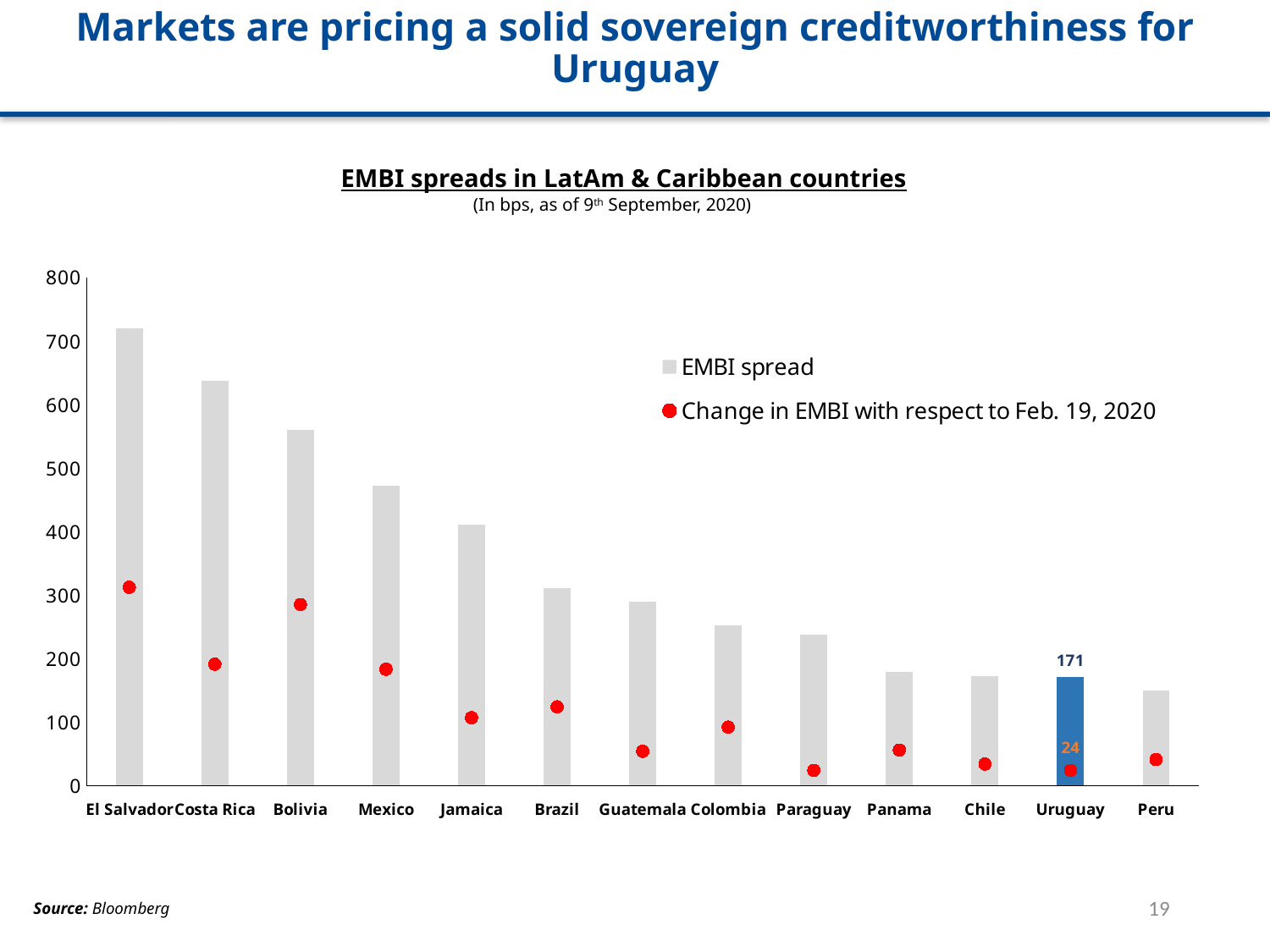
What kind of chart is used to show the EMBI spreads? Bar chart How many series does the legend list? 2 Which country has the lowest EMBI spread? Peru How many countries are shown on the x axis? 13 What is the change in EMBI with respect to Feb. 19, 2020 shown for Uruguay? 24 Which has a larger EMBI spread, Costa Rica or Bolivia? Costa Rica What is the EMBI spread value shown for Uruguay? 171 Do the EMBI spread bars rise or fall from left to right across the countries? Fall Which country's bar is highlighted in blue? Uruguay Which country has the highest EMBI spread? El Salvador Is the EMBI spread for El Salvador greater or less than 700? greater Is the EMBI spread for Mexico greater or less than 500? less